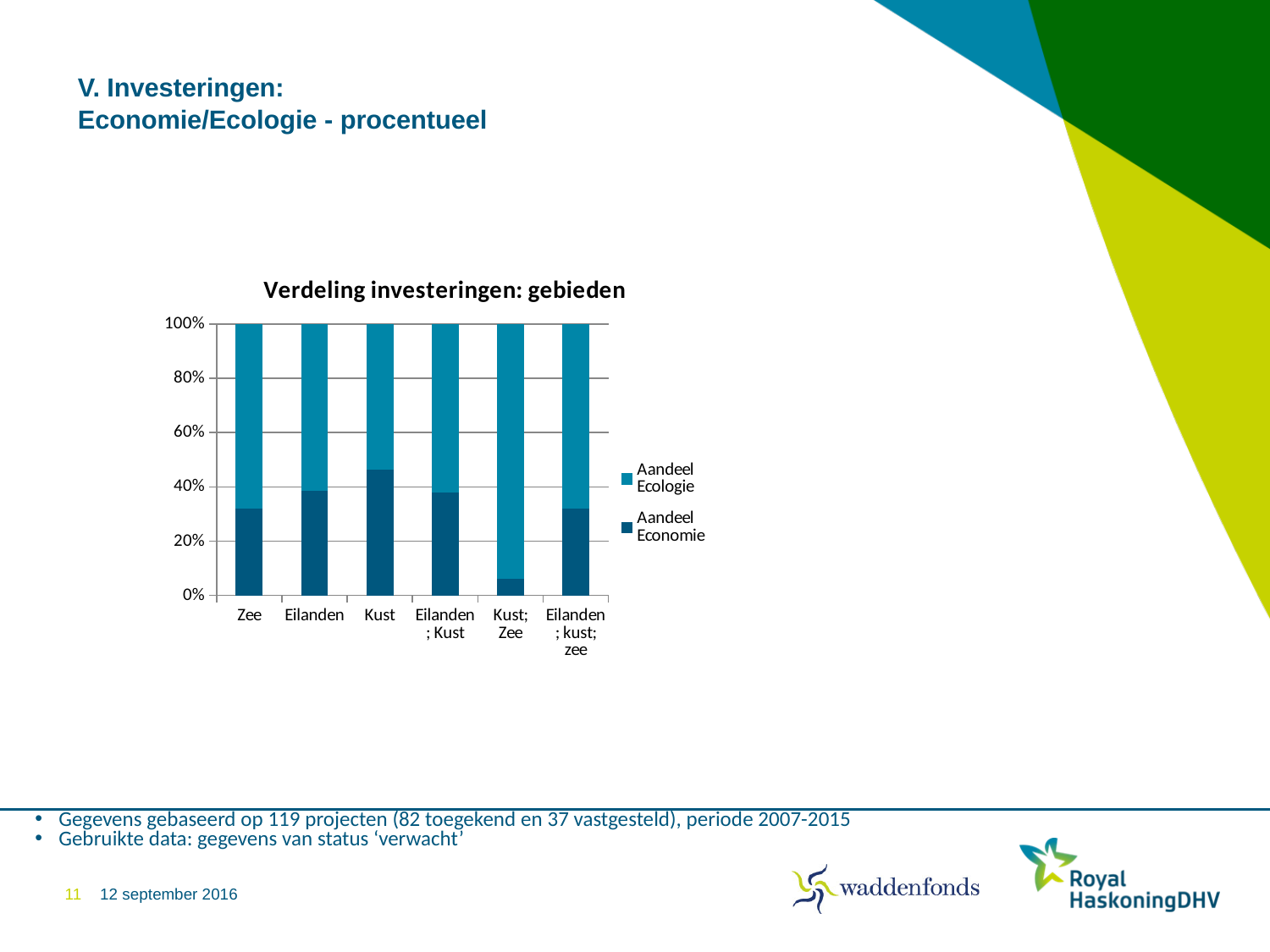
What is the total height of each stacked bar? 100% How many categories are shown on the x axis? 6 Which series is shown in the darker blue colour at the bottom of each bar? Aandeel Economie Is the Aandeel Economie value for Zee greater or less than 40%? less How many series does the legend list? 2 Is the Aandeel Economie value for Kust greater or less than 40%? greater Which category has the lowest share for Aandeel Economie? Kust; Zee Which category has the highest share for Aandeel Economie? Kust What is the title of the chart? Verdeling investeringen: gebieden What kind of chart is shown on the slide? Stacked bar chart Is the Aandeel Economie value for Kust; Zee greater or less than 20%? less Which has a larger Aandeel Economie share, Kust or Kust; Zee? Kust